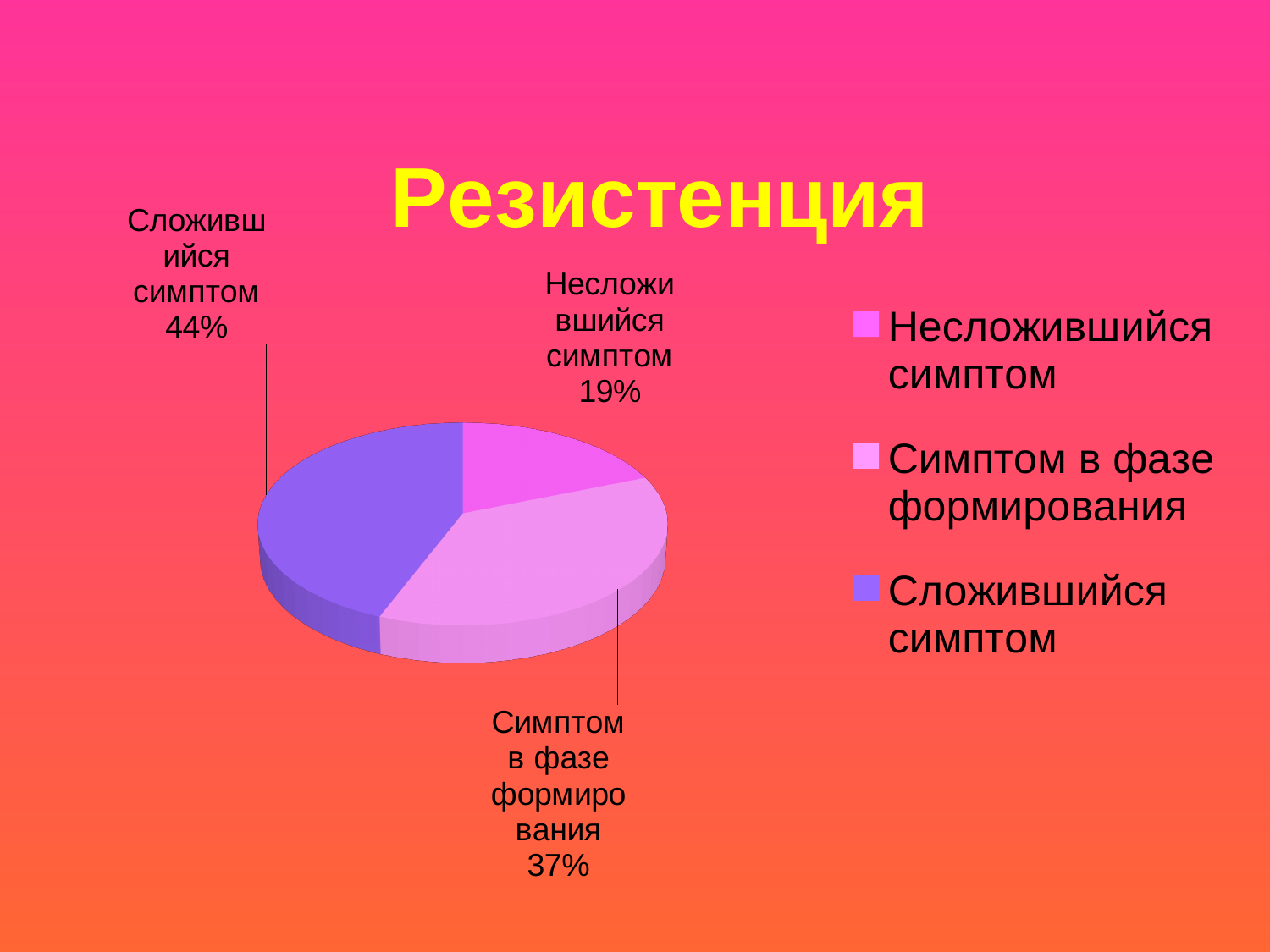
How many slices does the pie chart have? 3 How many entries does the legend list? 3 What is the difference in percentage points between "Сложившийся симптом" and "Несложившийся симптом"? 25 What share of the pie does "Несложившийся симптом" have? 19% What share of the pie does "Симптом в фазе формирования" have? 37% Which category has the largest slice of the pie? Сложившийся симптом Which is larger: the slice for "Симптом в фазе формирования" or the slice for "Несложившийся симптом"? Симптом в фазе формирования What is the difference in percentage points between "Сложившийся симптом" and "Симптом в фазе формирования"? 7 What kind of chart is shown on the slide? Pie chart What is the title of the chart? Резистенция What share of the pie does "Сложившийся симптом" have? 44% Which category has the smallest slice of the pie? Несложившийся симптом